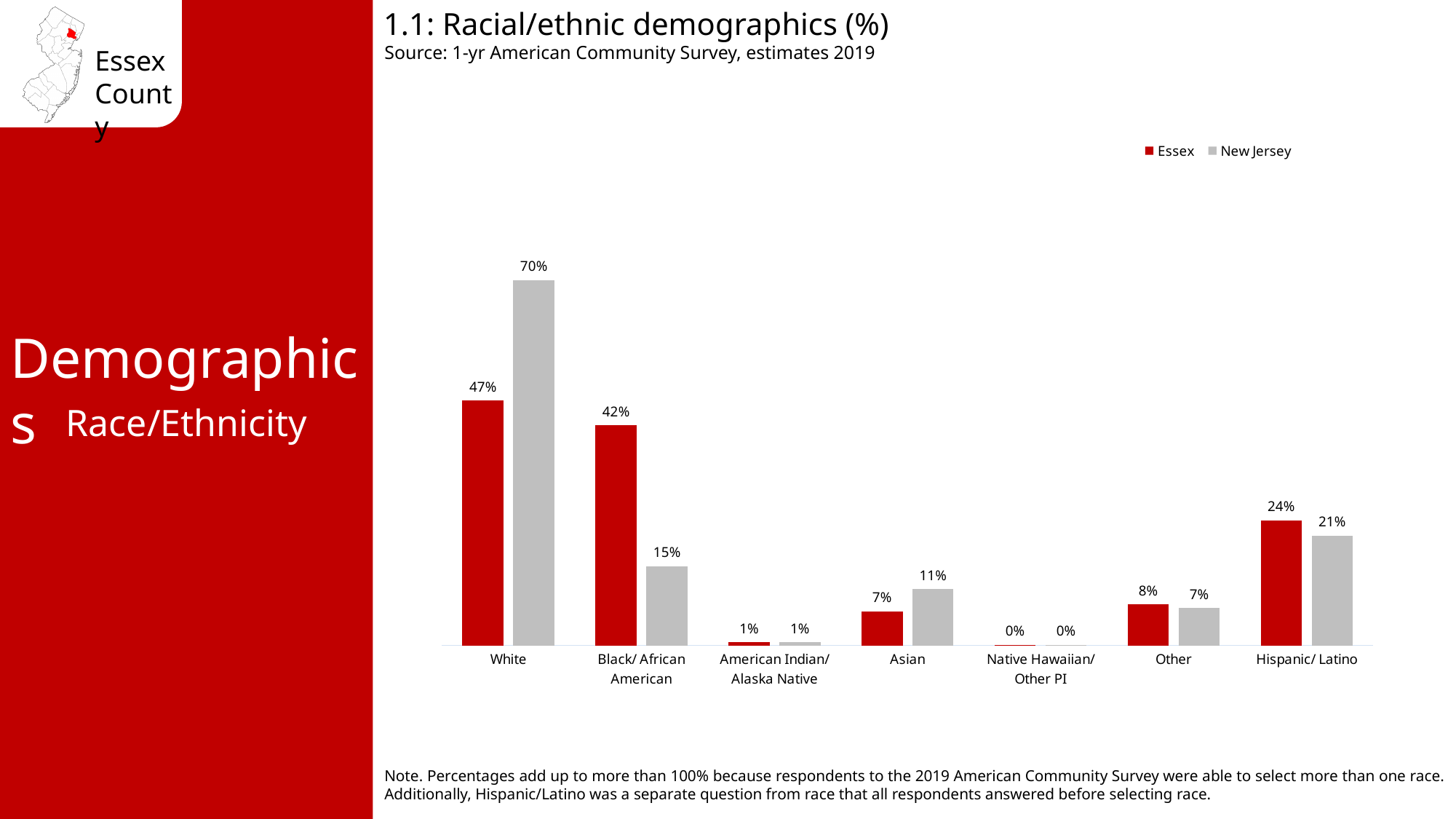
Which category has the highest New Jersey value? White Which is larger for Asian, the Essex value or the New Jersey value? New Jersey What is the New Jersey value for Black/ African American? 15% Which category has the lowest Essex value? Native Hawaiian/ Other PI What kind of chart is shown on the slide? Bar chart What is the Essex value for Hispanic/ Latino? 24% What is the difference between the Essex and New Jersey values for Black/ African American? 27% How many categories are shown on the x axis? 7 What is the difference between the New Jersey and Essex values for White? 23% How many series does the legend list? 2 What is the Essex value for White? 47% What is the New Jersey value for Asian? 11%